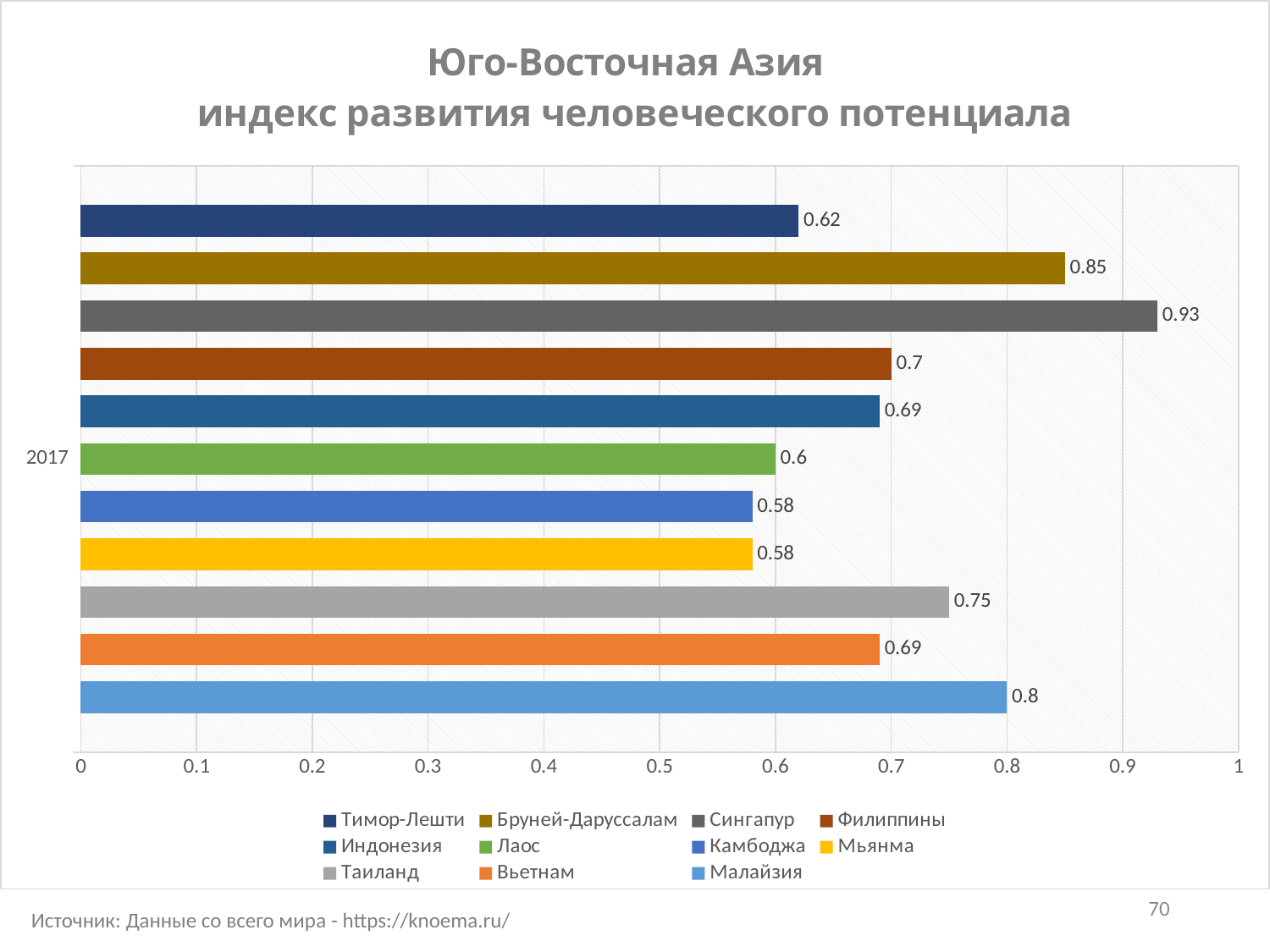
What is the human development index value for Сингапур in 2017? 0.93 What is the difference between the values for Бруней-Даруссалам and Таиланд? 0.1 What value is shown for Малайзия? 0.8 Which is larger, the value for Малайзия or the value for Таиланд? Малайзия What is the value for Бруней-Даруссалам? 0.85 Which year is shown on the vertical axis of the chart? 2017 What kind of chart is shown on the slide? Bar chart How many series does the legend list? 11 What is the difference between the values for Сингапур and Тимор-Лешти? 0.31 Which is larger, the value for Филиппины or the value for Камбоджа? Филиппины What value does the bar for Лаос show? 0.6 Which country has the highest human development index on the chart? Сингапур